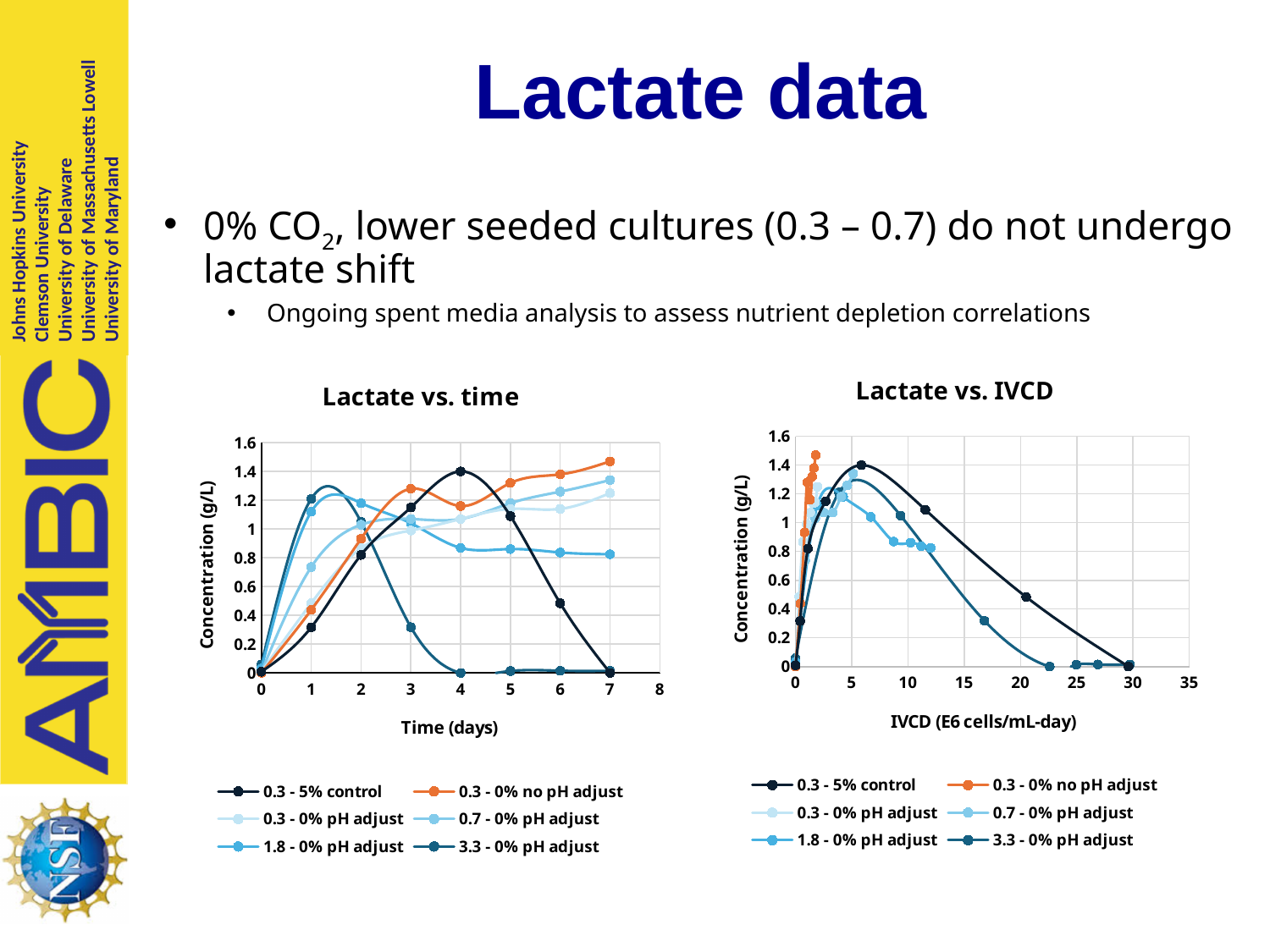
In the "Lactate vs. IVCD" chart, is the value for 0.3 - 5% control at its highest IVCD point (around 30) greater or less than 0.2? less In the "Lactate vs. time" chart, is the value for 1.8 - 0% pH adjust at day 7 greater or less than 0.6? greater In the "Lactate vs. time" chart, which is larger at day 7: 0.3 - 5% control or 0.7 - 0% pH adjust? 0.7 - 0% pH adjust What is the x-axis title of the "Lactate vs. time" chart? Time (days) In the "Lactate vs. time" chart, is the value for 3.3 - 0% pH adjust at day 4 greater or less than 0.2? less What kind of chart is the "Lactate vs. time" chart? line chart What is the x-axis title of the "Lactate vs. IVCD" chart? IVCD (E6 cells/mL-day) How many series does the legend of the "Lactate vs. time" chart list? 6 In the "Lactate vs. time" chart, which series has the highest concentration at day 7? 0.3 - 0% no pH adjust In the "Lactate vs. time" chart, does the 0.3 - 5% control series rise or fall between day 4 and day 7? fall